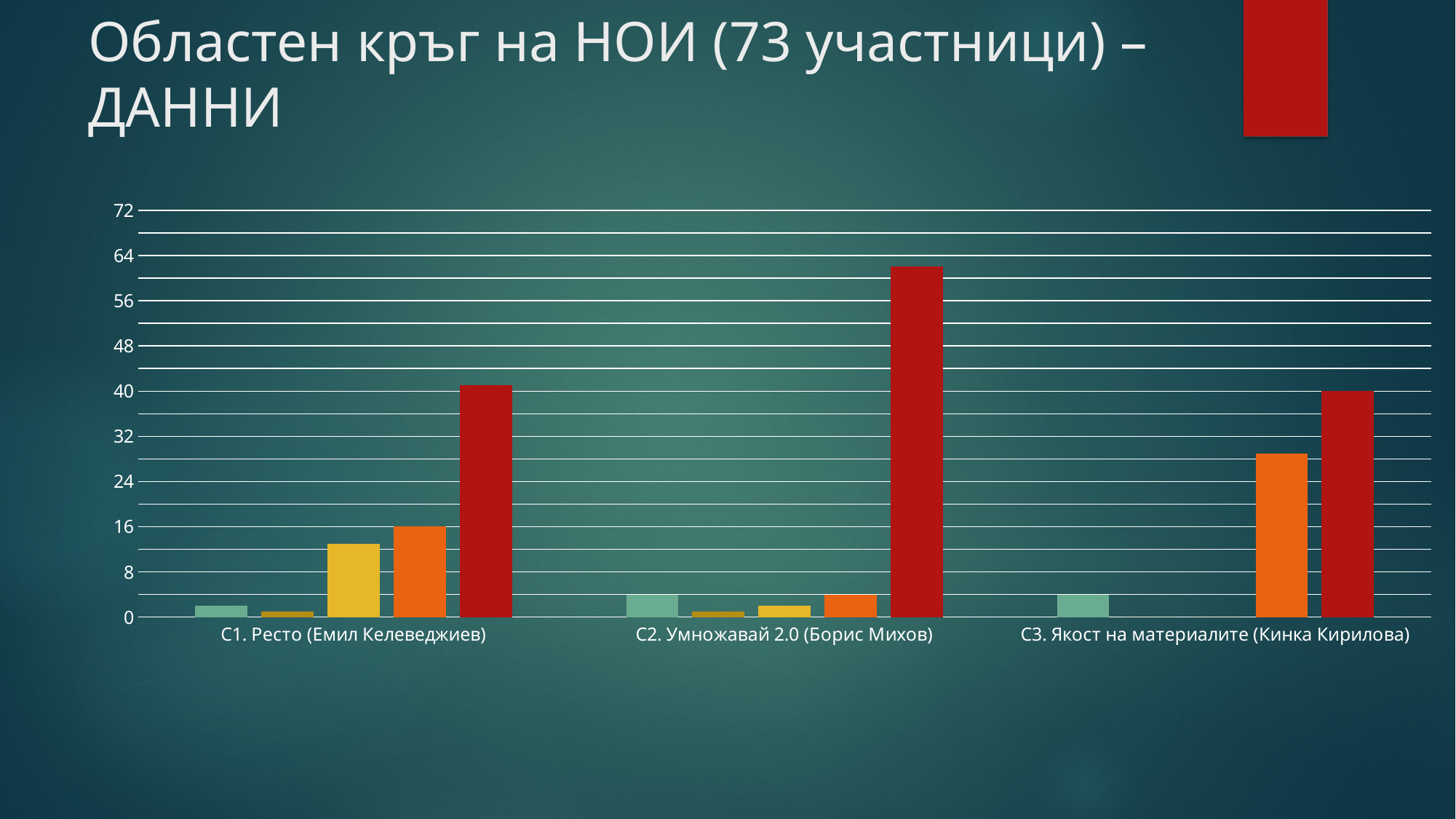
Which is larger: the orange bar for C1. Ресто (Емил Келеведжиев) or the orange bar for C3. Якост на материалите (Кинка Кирилова)? C3. Якост на материалите (Кинка Кирилова) What kind of chart is shown on the slide? bar chart Is the red bar for C2. Умножавай 2.0 (Борис Михов) greater or less than 56? greater Which category has the tallest orange bar? C3. Якост на материалите (Кинка Кирилова) What is the highest value shown on the y axis of the chart? 72 What is the title of the slide containing the chart? Областен кръг на НОИ (73 участници) – ДАННИ How many categories are shown on the x axis of the chart? 3 Is the red bar for C1. Ресто (Емил Келеведжиев) greater or less than 48? less Is the orange bar for C2. Умножавай 2.0 (Борис Михов) greater or less than 8? less Which category has the tallest red bar? C2. Умножавай 2.0 (Борис Михов)